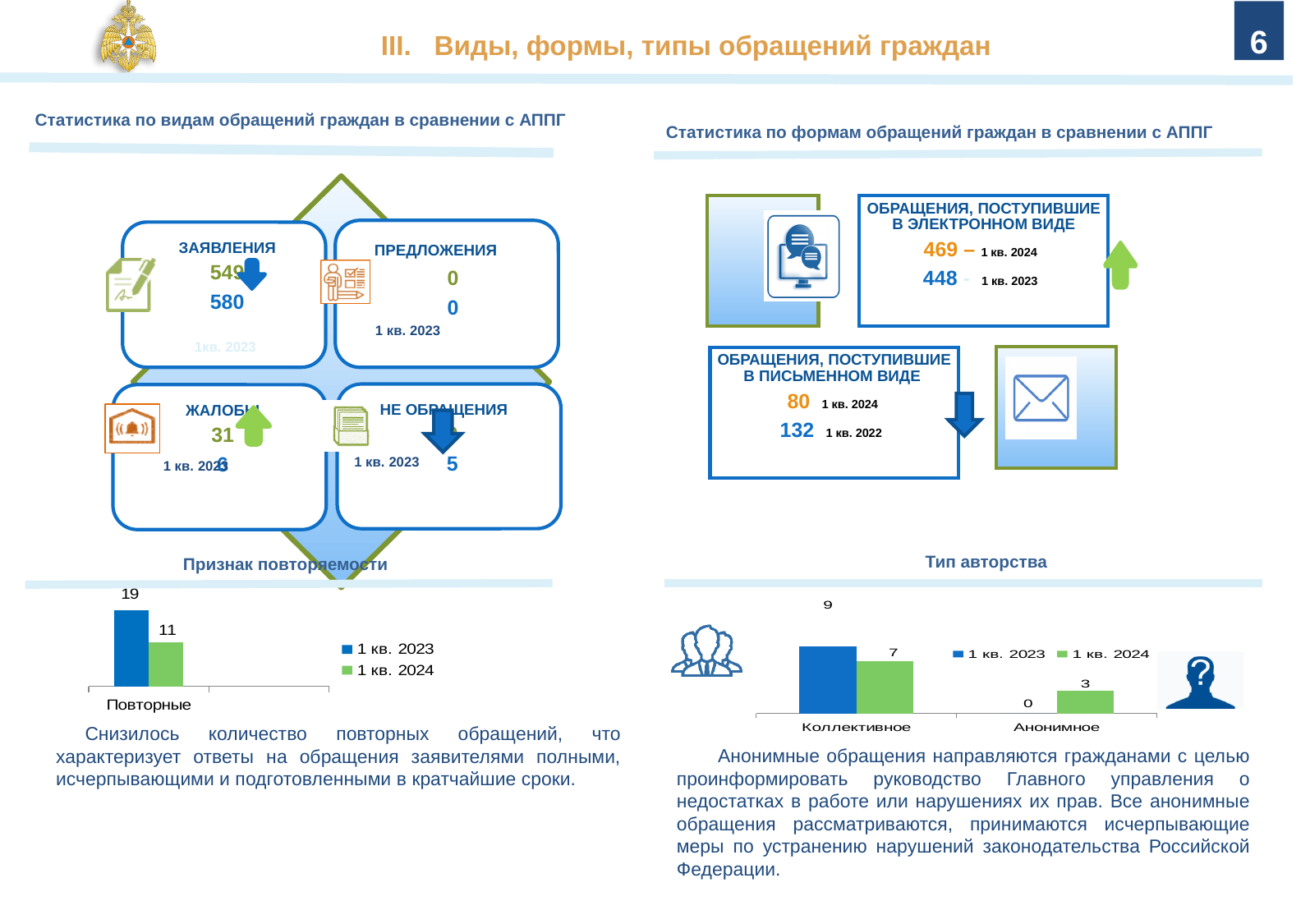
In the 'Тип авторства' chart, what is the value for Коллективное in 1 кв. 2023? 9 In the 'Признак повторяемости' chart, what is the value for 1 кв. 2024? 11 In the 'Признак повторяемости' chart, what is the value for 1 кв. 2023? 19 In the 'Тип авторства' chart, what is the value for Анонимное in 1 кв. 2024? 3 In the 'Тип авторства' chart, what is the value for Анонимное in 1 кв. 2023? 0 In the 'Тип авторства' chart, what is the difference between Коллективное in 1 кв. 2023 and 1 кв. 2024? 2 In the 'Тип авторства' chart, which category has the highest value in 1 кв. 2024? Коллективное In the 'Тип авторства' chart, which is larger: Коллективное in 1 кв. 2024 or Анонимное in 1 кв. 2024? Коллективное in 1 кв. 2024 In the 'Тип авторства' chart, how many categories are shown on the x axis? 2 In the 'Признак повторяемости' chart, how many series does the legend list? 2 What kind of chart is the 'Признак повторяемости' chart? bar chart In the 'Признак повторяемости' chart, what is the difference between the 1 кв. 2023 and 1 кв. 2024 values? 8